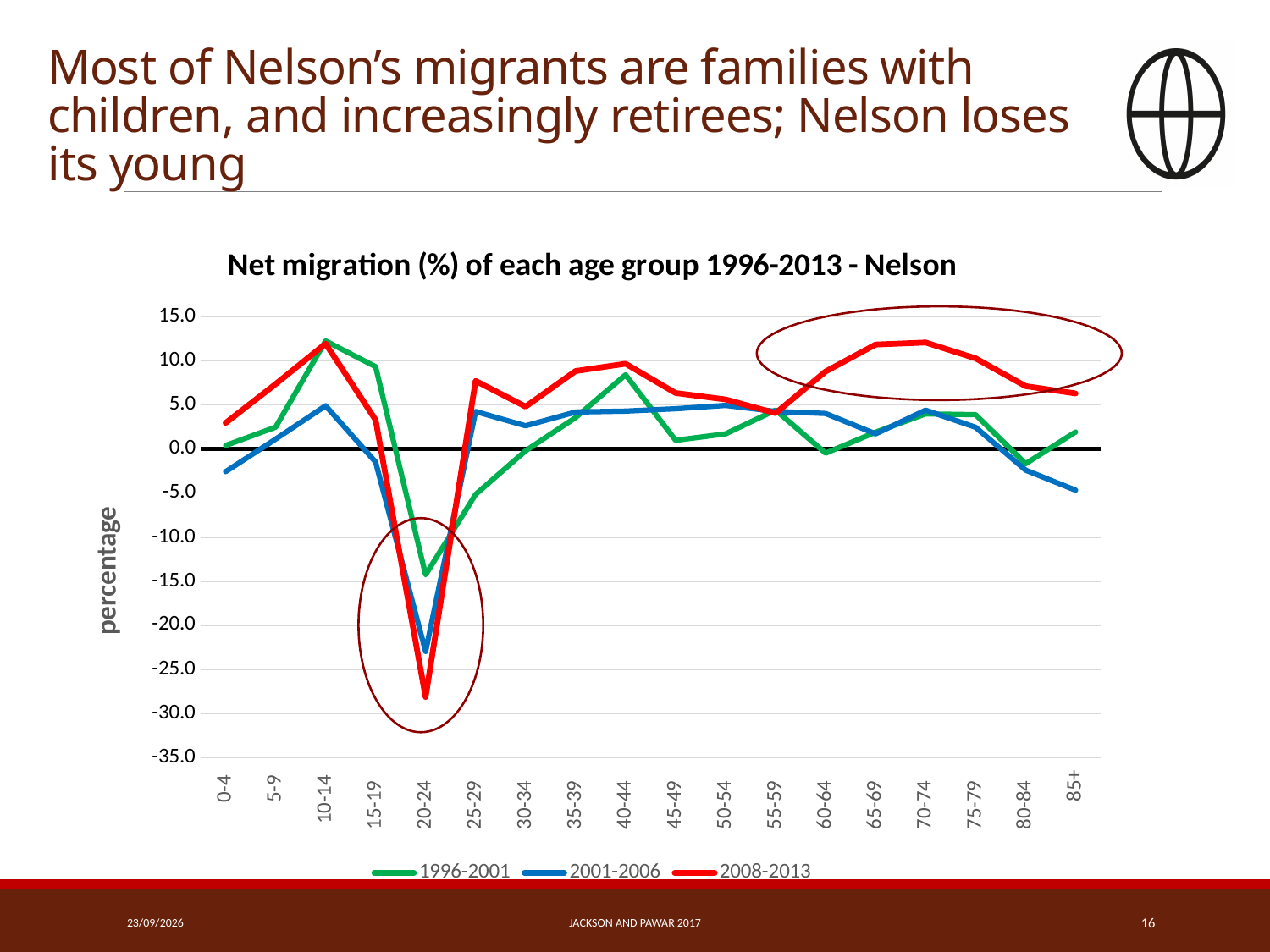
At age group 70-74, is the 2008-2013 value higher or lower than the 2001-2006 value? higher What type of chart is shown on the slide? line chart At age group 20-24, which series has the lowest value? 2008-2013 Is the value for the 2001-2006 series at age group 85+ greater or less than 0.0? less Does the 2008-2013 series rise or fall from age group 55-59 to 70-74? rise How many age groups are shown on the x axis? 18 Is the value for the 2008-2013 series at age group 65-69 greater or less than 10.0? greater How many series does the legend list? 3 Is the value for the 2008-2013 series at age group 20-24 greater or less than -25.0? less What is the label on the vertical axis of the chart? percentage For which age group is the 2008-2013 series at its lowest value? 20-24 For which age group is the 1996-2001 series at its highest value? 10-14